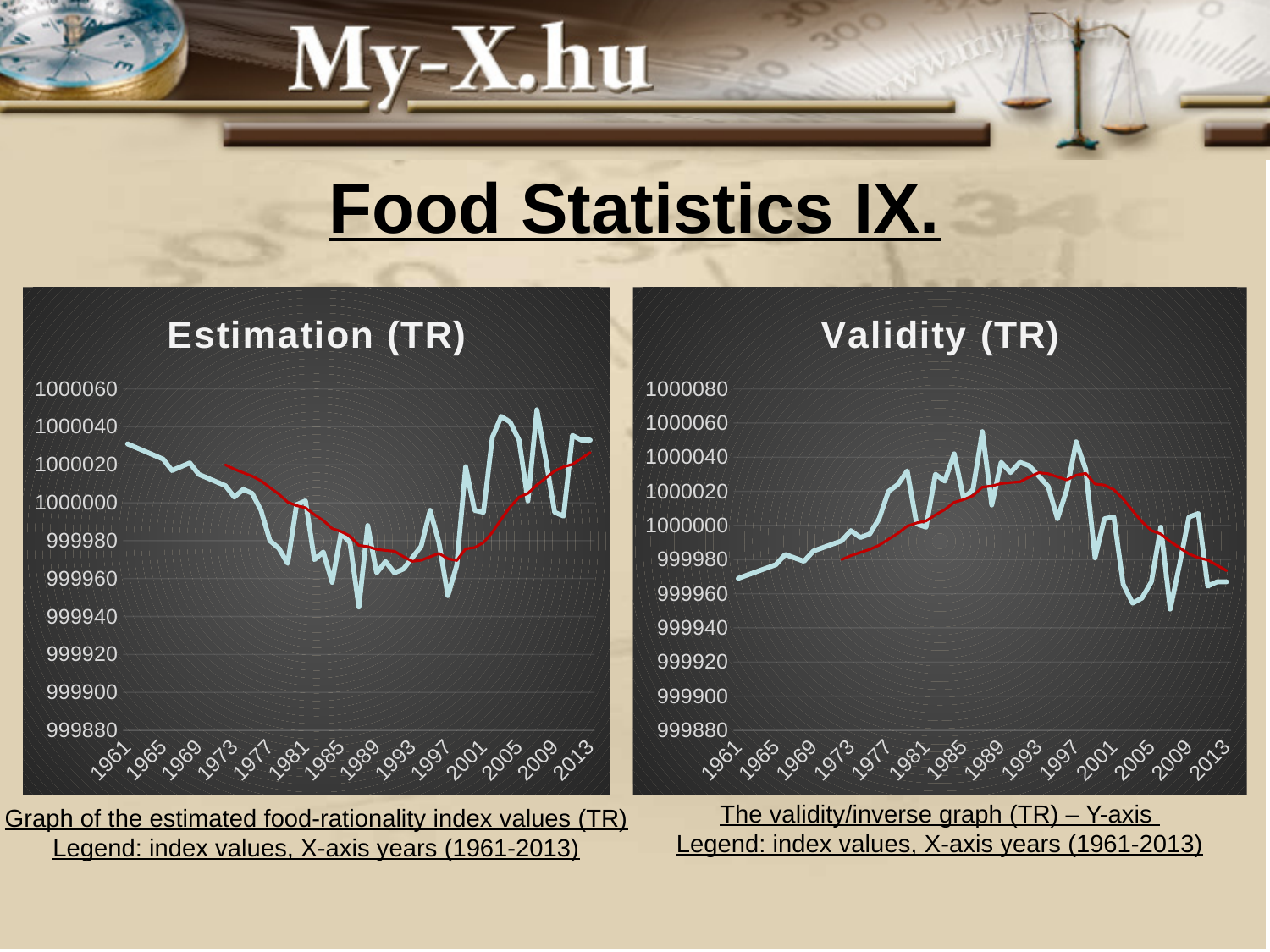
In the Estimation (TR) chart, which is larger, the value for 1961 or the value for 1989? 1961 In the Validity (TR) chart, does the red smoothed line rise or fall between 1997 and 2013? fall In the Validity (TR) chart, is the value for 2009 greater or less than 999960? greater In the Validity (TR) chart, is the value for 1961 greater or less than 1000000? less What kind of chart is the Estimation (TR) chart? line chart What kind of chart is the Validity (TR) chart? line chart In the Estimation (TR) chart, is the lowest value of the light blue line (around 1989) greater or less than 999960? less What is the title of the chart on the left side of the slide? Estimation (TR) What is the title of the chart on the right side of the slide? Validity (TR) In the Estimation (TR) chart, does the red smoothed line rise or fall between 2001 and 2013? rise